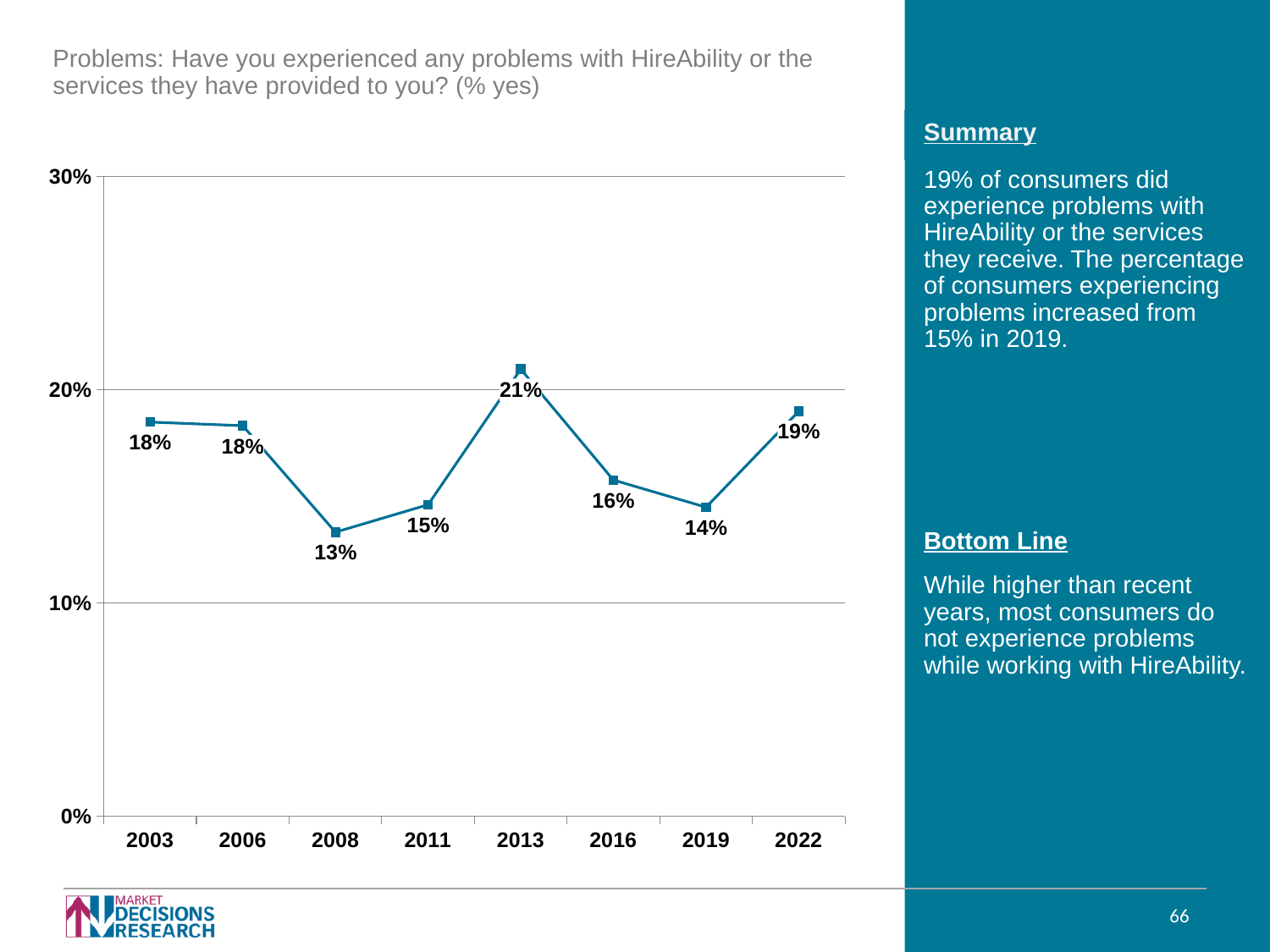
What percentage of consumers reported experiencing problems in 2013? 21% What is the difference between the 2013 value and the 2008 value? 8% Which year has a higher value, 2016 or 2019? 2016 What kind of chart is shown on the slide? Line chart Is the value for 2013 greater or less than 20%? greater What is the difference between the 2022 value and the 2019 value? 5% Which year has the highest percentage of consumers reporting problems? 2013 Did the percentage rise or fall from 2019 to 2022? Rise What is the value shown for 2008? 13% What percentage is shown for 2022? 19% How many years are plotted on the chart? 8 Which year has the lowest percentage of consumers reporting problems? 2008